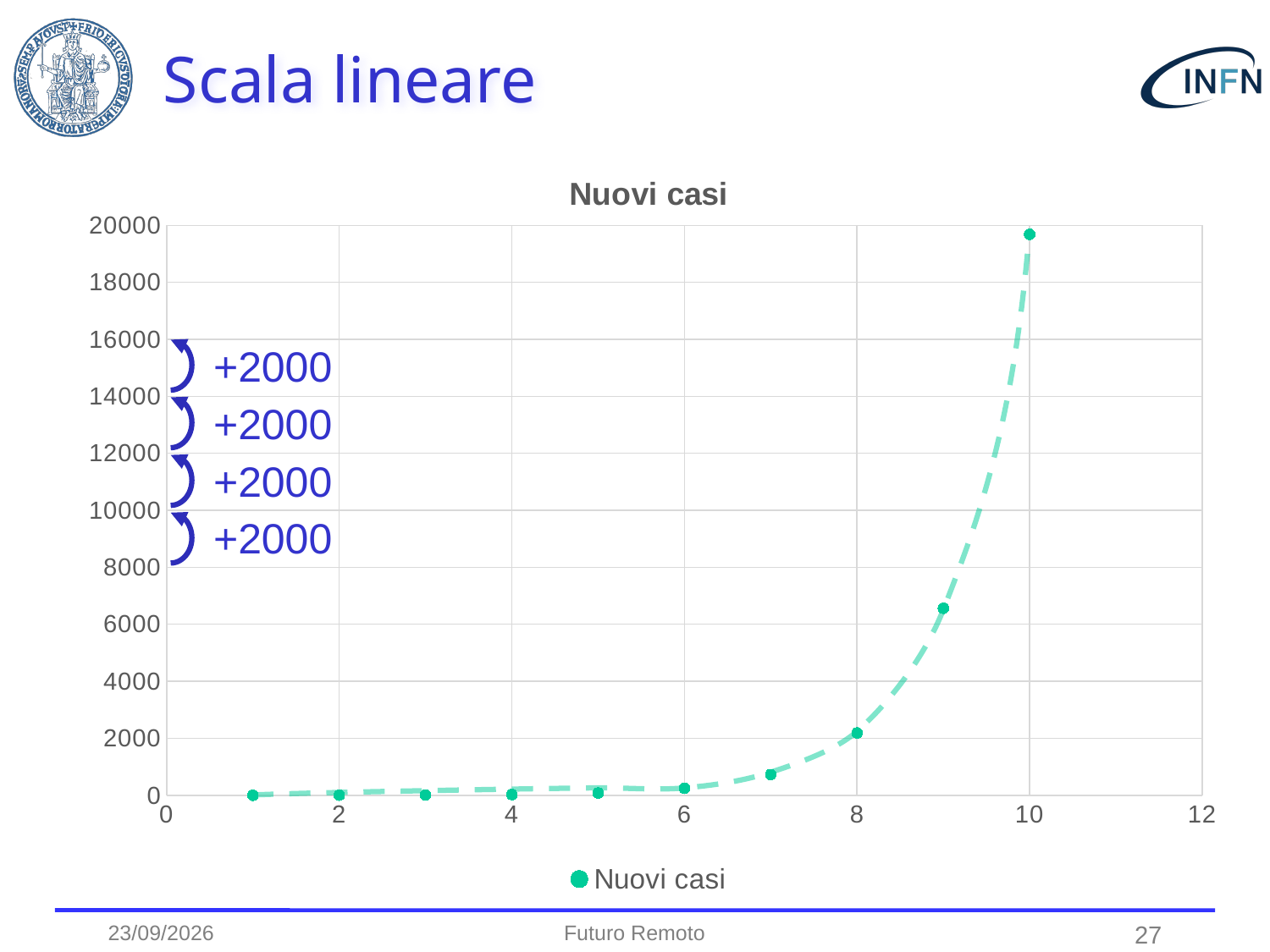
How many data points are plotted on the chart? 10 What kind of chart is shown on the slide? line chart How many series does the legend list? 1 Which is larger, the value at x = 9 or the value at x = 8? x = 9 Do the values rise or fall as x increases from 1 to 10? rise Is the value at x = 10 greater or less than 18000? greater At which x value does the series reach its highest value? 10 What increment is written next to the arrows along the y axis? +2000 Is the value at x = 9 greater or less than 8000? less Is the value at x = 7 greater or less than 2000? less What is the title of the chart? Nuovi casi